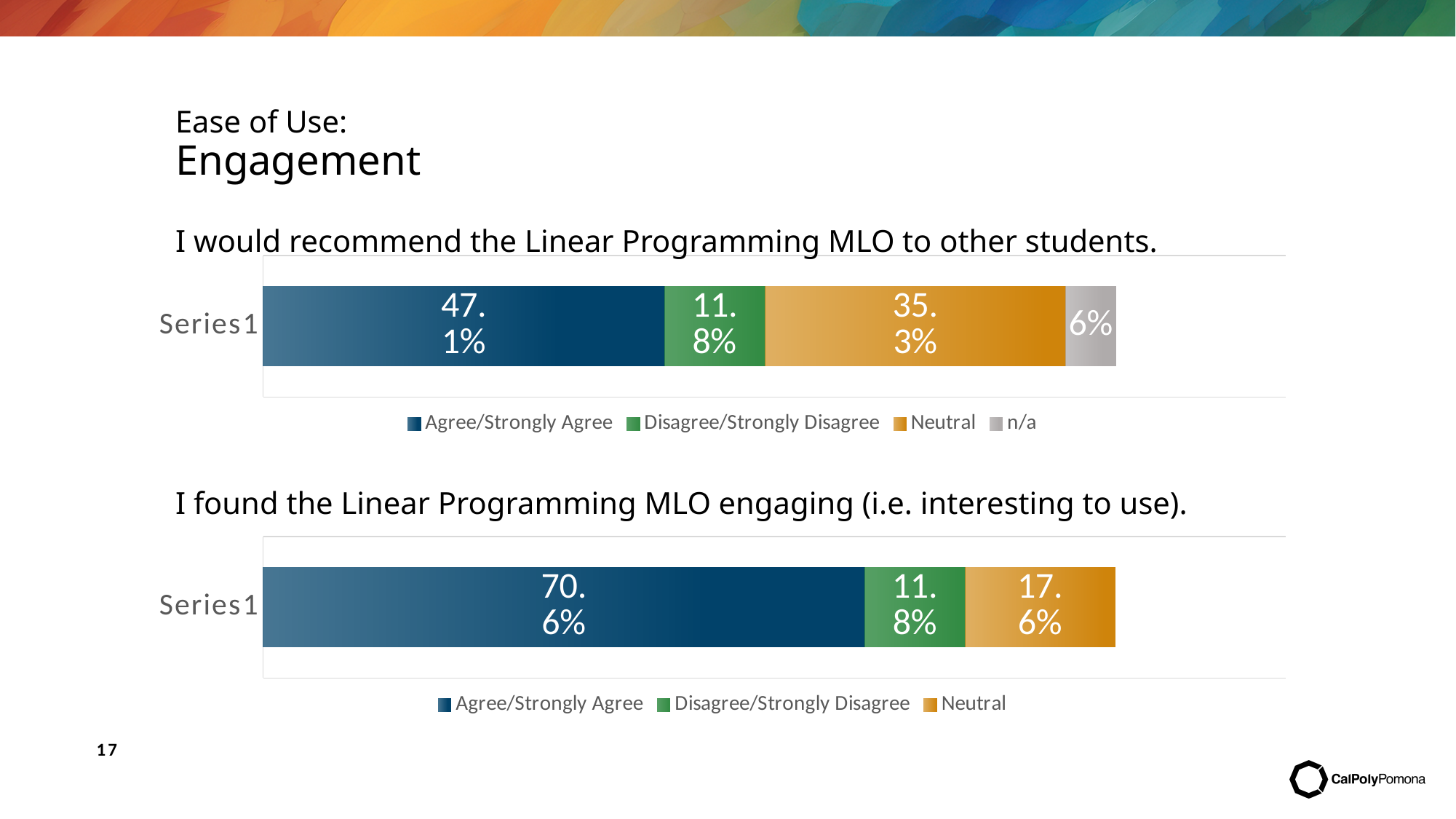
In the chart for "I found the Linear Programming MLO engaging (i.e. interesting to use).", how much larger is the Agree/Strongly Agree share than the Neutral share? 53% In the chart for "I would recommend the Linear Programming MLO to other students.", how much larger is the Agree/Strongly Agree share than the Neutral share? 11.8% In the chart for "I found the Linear Programming MLO engaging (i.e. interesting to use).", what percentage is shown for Neutral? 17.6% In the chart for "I found the Linear Programming MLO engaging (i.e. interesting to use).", which response category has the smallest share? Disagree/Strongly Disagree What kind of chart is used for "I found the Linear Programming MLO engaging (i.e. interesting to use)."? Stacked bar chart In the chart for "I would recommend the Linear Programming MLO to other students.", what percentage is shown for n/a? 6% In the chart for "I would recommend the Linear Programming MLO to other students.", what percentage is shown for Neutral? 35.3% In the chart for "I would recommend the Linear Programming MLO to other students.", what percentage is shown for Agree/Strongly Agree? 47.1% In the chart for "I would recommend the Linear Programming MLO to other students.", which response category has the largest share? Agree/Strongly Agree In the chart for "I found the Linear Programming MLO engaging (i.e. interesting to use).", what percentage is shown for Agree/Strongly Agree? 70.6% Which chart has the larger Agree/Strongly Agree share: the top chart about recommending the MLO or the bottom chart about finding the MLO engaging? The bottom chart (finding the MLO engaging) How many series does the legend list for the chart "I would recommend the Linear Programming MLO to other students."? 4